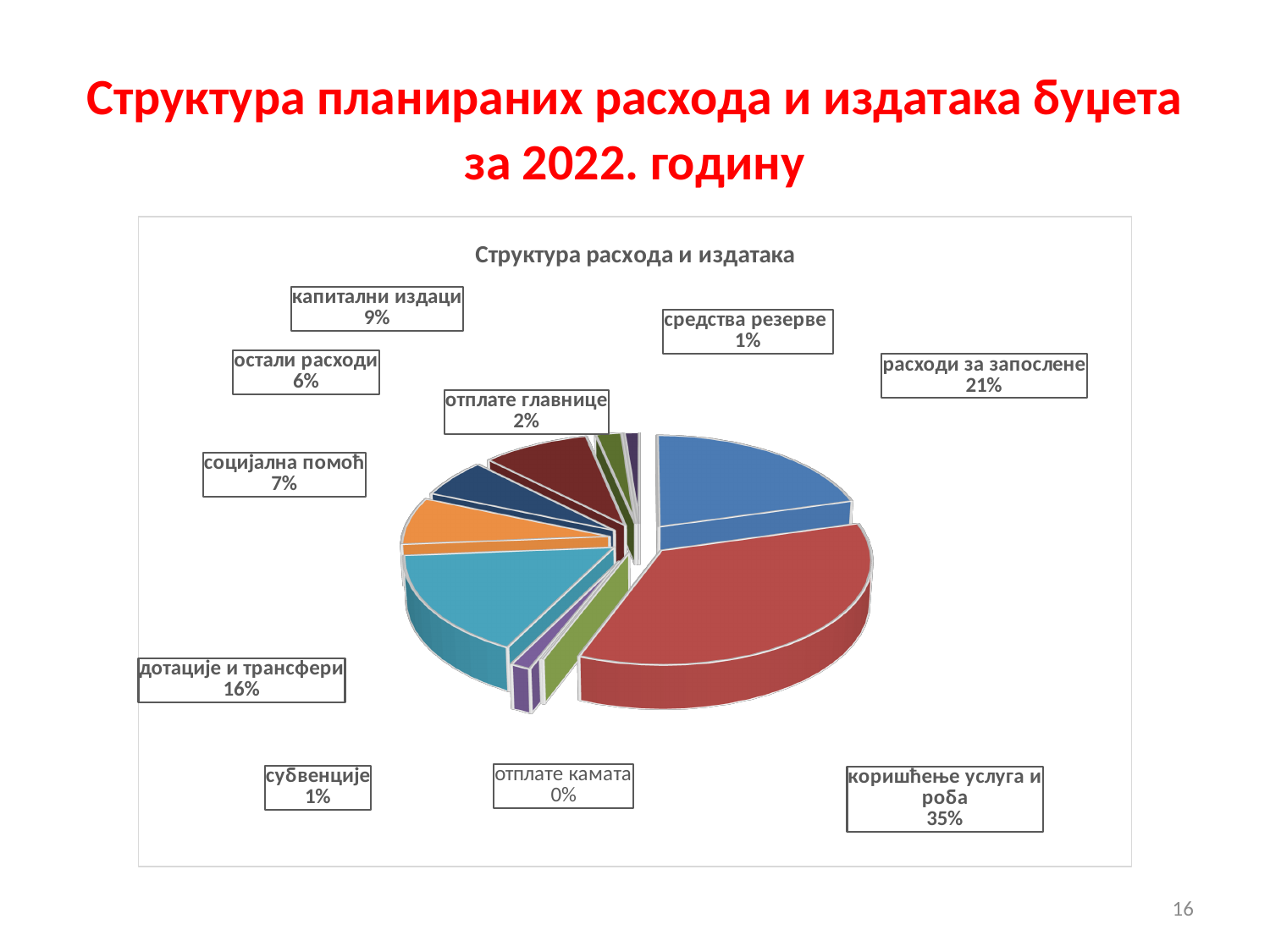
Which category has the smallest share of the pie? отплате камата Which is larger, the share for социјална помоћ or the share for остали расходи? социјална помоћ What is the difference in percentage points between коришћење услуга и роба and расходи за запослене? 14 What share of the pie is labelled for дотације и трансфери? 16% How many categories are shown in the pie chart? 10 What share of the pie is labelled for отплате главнице? 2% What share of the pie is labelled for расходи за запослене? 21% What is the title of the chart? Структура расхода и издатака Which category has the largest share of the pie? коришћење услуга и роба What kind of chart is shown on the slide? pie chart